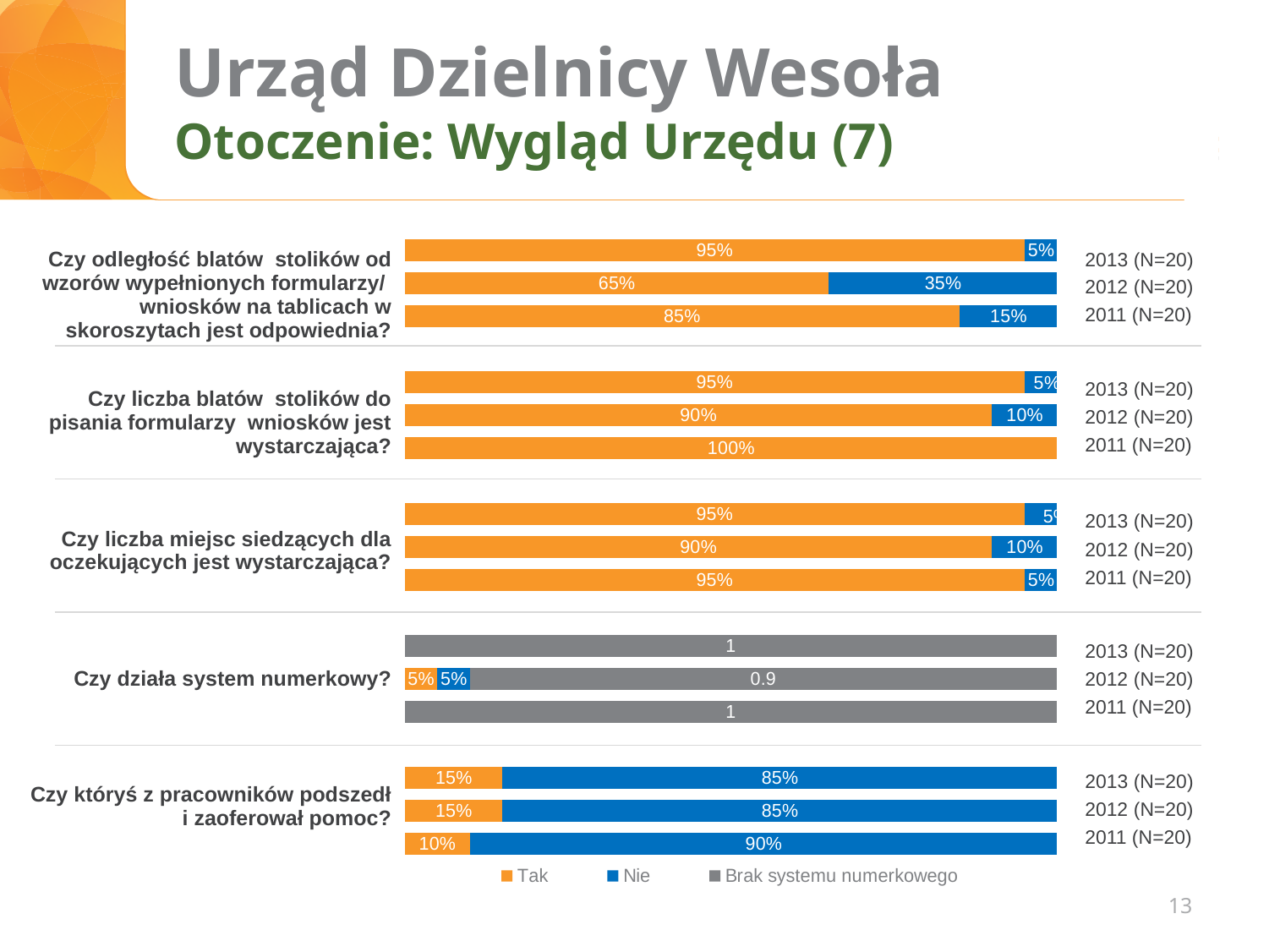
How many series does the legend list? 3 What percentage answered "Tak" in 2011 for the question "Czy liczba blatów stolików do pisania formularzy wniosków jest wystarczająca?"? 100% What percentage answered "Nie" in 2012 for the question "Czy liczba miejsc siedzących dla oczekujących jest wystarczająca?"? 10% What value is shown for "Brak systemu numerkowego" in 2012 for the question "Czy działa system numerkowy?"? 0.9 What percentage answered "Tak" in 2013 for the question "Czy odległość blatów stolików od wzorów wypełnionych formularzy/wniosków na tablicach w skoroszytach jest odpowiednia?"? 95% For the question "Czy odległość blatów stolików od wzorów wypełnionych formularzy/wniosków na tablicach w skoroszytach jest odpowiednia?", what is the difference between the "Tak" share in 2013 and in 2012? 30 percentage points What percentage answered "Nie" in 2012 for the question "Czy odległość blatów stolików od wzorów wypełnionych formularzy/wniosków na tablicach w skoroszytach jest odpowiednia?"? 35% For the question "Czy któryś z pracowników podszedł i zaoferował pomoc?", which year had the higher "Tak" share: 2013 or 2011? 2013 What percentage answered "Nie" in 2011 for the question "Czy któryś z pracowników podszedł i zaoferował pomoc?"? 90% What is the sample size (N) shown for each year on the slide? N=20 For the question "Czy odległość blatów stolików od wzorów wypełnionych formularzy/wniosków na tablicach w skoroszytach jest odpowiednia?", which year had the lowest "Tak" share? 2012 What kind of chart is shown on the slide? Stacked bar chart